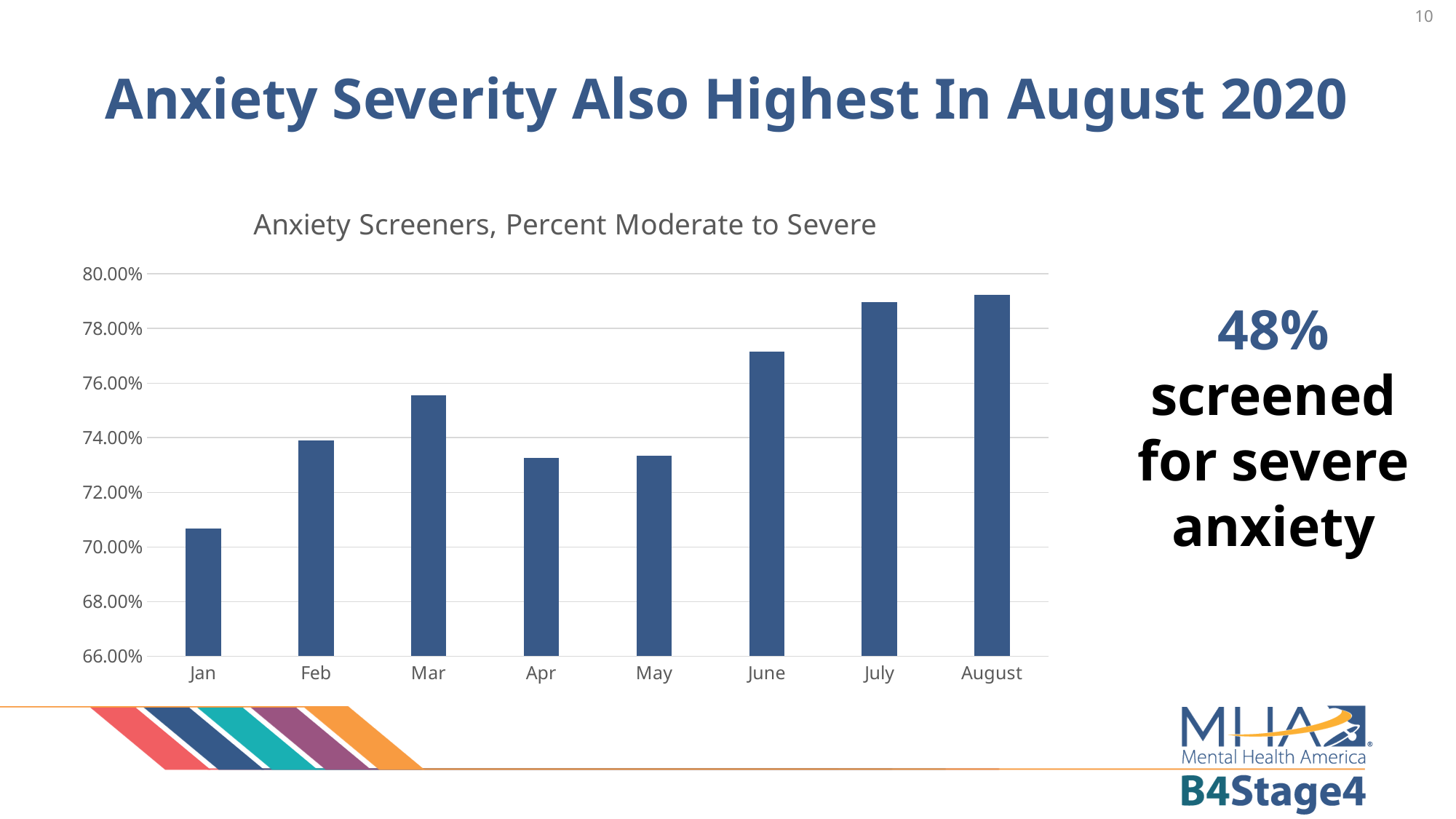
Is the value for July greater or less than 78.00%? greater Is the value for Apr greater or less than 74.00%? less What is the title of the chart? Anxiety Screeners, Percent Moderate to Severe Do the values generally rise or fall from Jan to August? rise Is the value for Mar greater or less than 74.00%? greater Which is larger, the value for Mar or the value for Apr? Mar What kind of chart is shown on the slide? bar chart How many months are plotted on the chart? 8 Which month has the highest percent moderate to severe? August Which month has the lowest percent moderate to severe? Jan